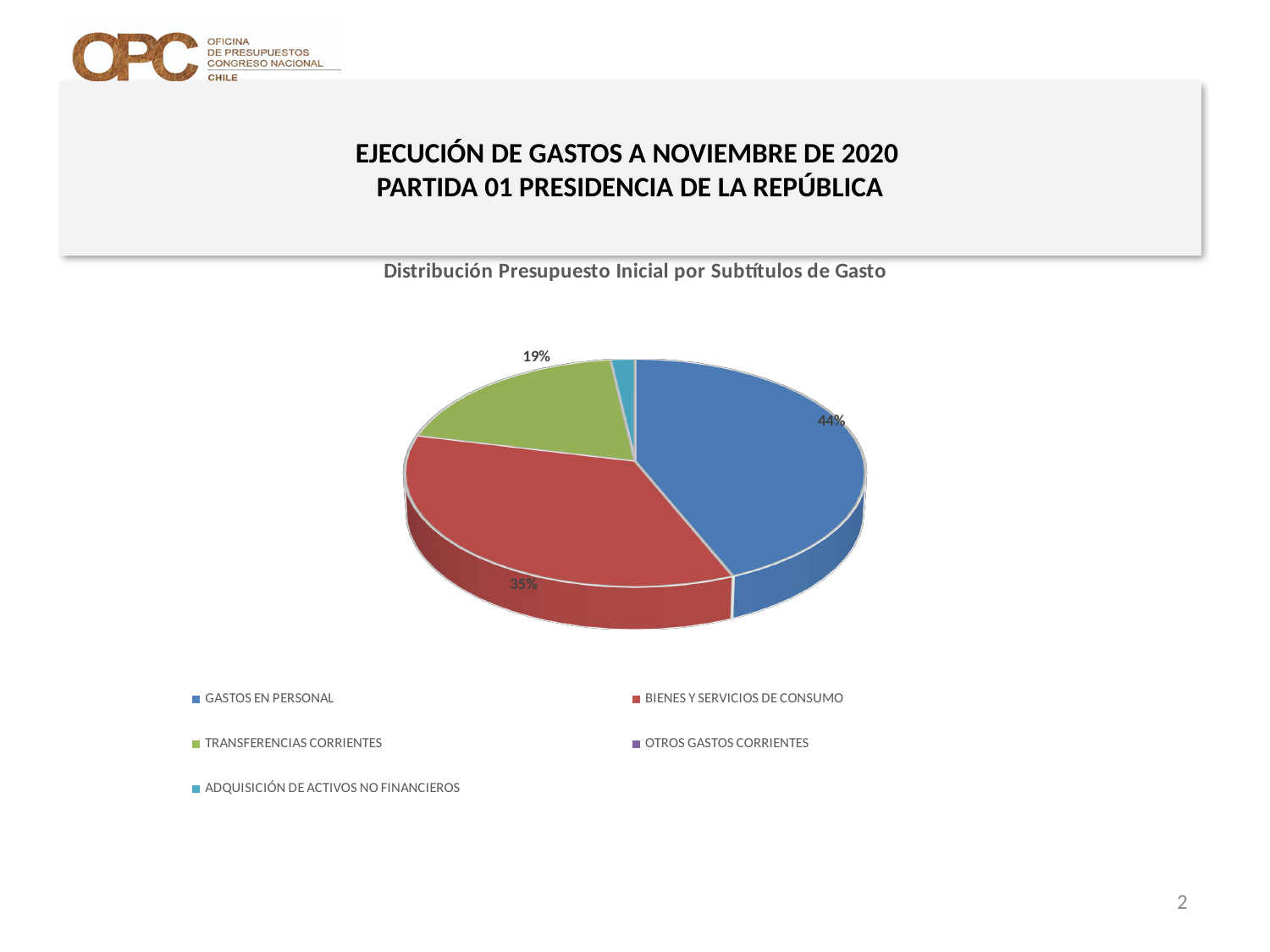
What is the difference in percentage points between BIENES Y SERVICIOS DE CONSUMO and TRANSFERENCIAS CORRIENTES? 16 percentage points What is the difference in percentage points between GASTOS EN PERSONAL and BIENES Y SERVICIOS DE CONSUMO? 9 percentage points What kind of chart is shown on the slide? Pie chart What share of the pie does GASTOS EN PERSONAL represent? 44% Which slice is larger, TRANSFERENCIAS CORRIENTES or ADQUISICIÓN DE ACTIVOS NO FINANCIEROS? TRANSFERENCIAS CORRIENTES How many categories does the legend list? 5 What percentage is shown for BIENES Y SERVICIOS DE CONSUMO? 35% What is the title of the chart? Distribución Presupuesto Inicial por Subtítulos de Gasto Which category has the largest slice of the pie? GASTOS EN PERSONAL What colour is the GASTOS EN PERSONAL slice? Blue Which is larger, GASTOS EN PERSONAL or BIENES Y SERVICIOS DE CONSUMO? GASTOS EN PERSONAL What percentage is shown for TRANSFERENCIAS CORRIENTES? 19%